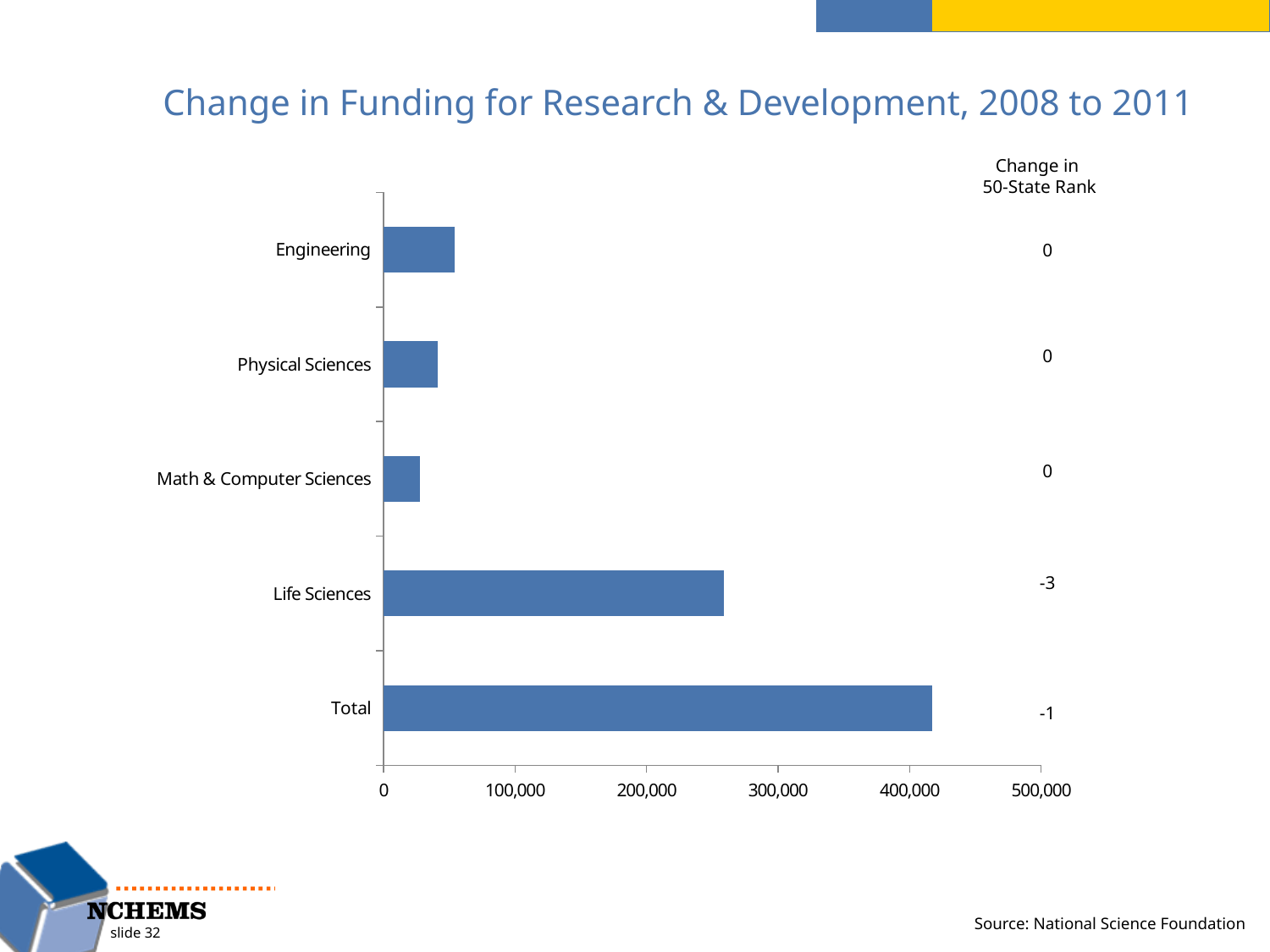
What is the Change in 50-State Rank shown for Life Sciences? -3 What is the title of the chart? Change in Funding for Research & Development, 2008 to 2011 Is the value for Total greater or less than 400,000? greater Is the value for Physical Sciences greater or less than 100,000? less Which category has the longest bar? Total Which is larger, the value for Life Sciences or the value for Math & Computer Sciences? Life Sciences Is the value for Engineering greater or less than 100,000? less What kind of chart is shown on the slide? bar chart Which is larger, the value for Engineering or the value for Physical Sciences? Engineering How many categories are plotted in the chart? 5 Which category has the shortest bar? Math & Computer Sciences